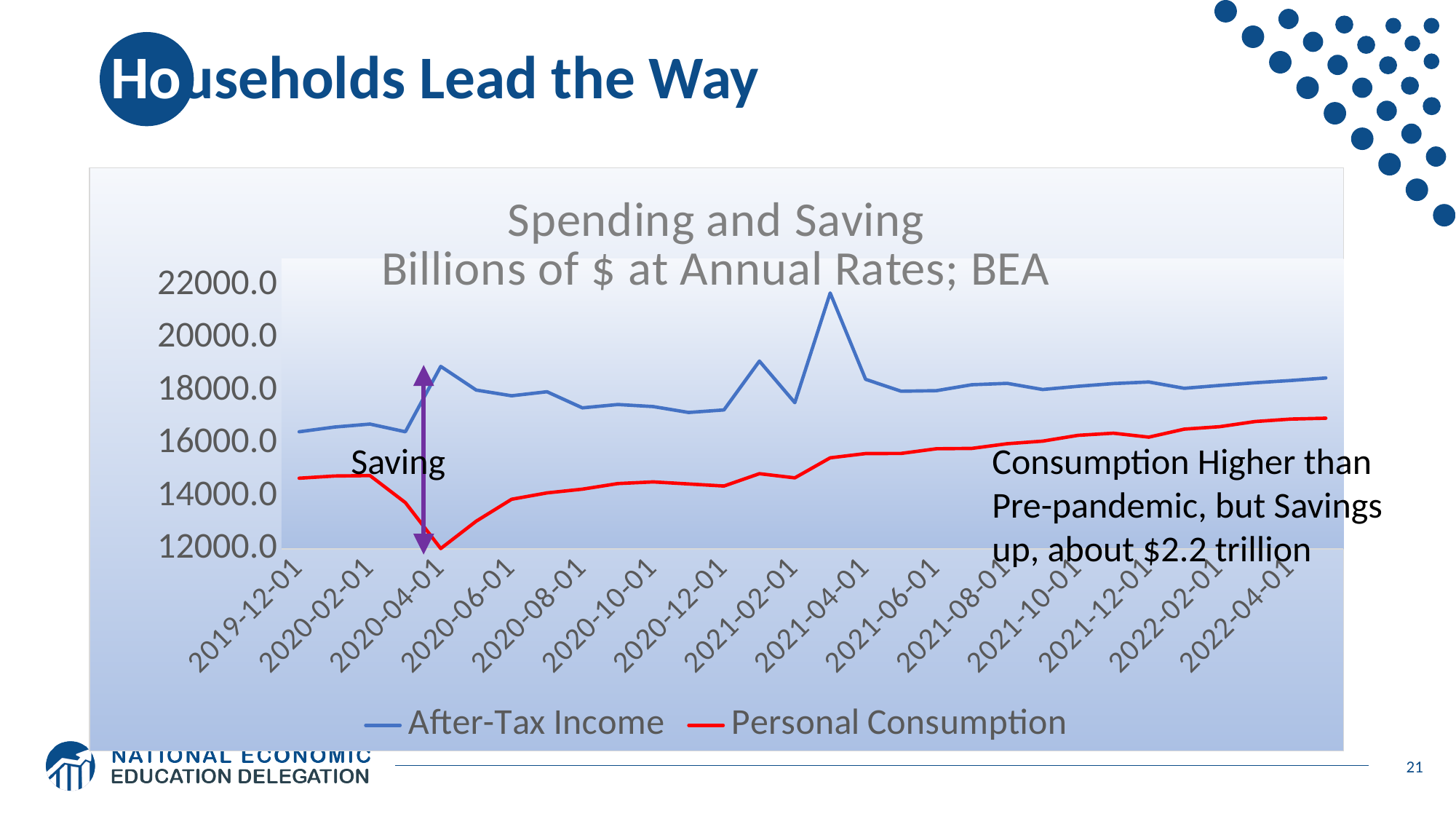
Which series has the higher values throughout the chart, After-Tax Income or Personal Consumption? After-Tax Income Is the value for Personal Consumption at 2019-12-01 greater or less than 14000? greater Which series is drawn in red? Personal Consumption Is the value for Personal Consumption at 2020-12-01 greater or less than 16000? less What kind of chart is shown on the slide? Line chart Is the highest value reached by After-Tax Income greater or less than 20000? greater Does Personal Consumption rise or fall from 2020-06-01 to 2022-04-01? rise How many series does the legend list? 2 What is the title of the chart? Spending and Saving Billions of $ at Annual Rates; BEA How many date labels are shown on the x axis? 15